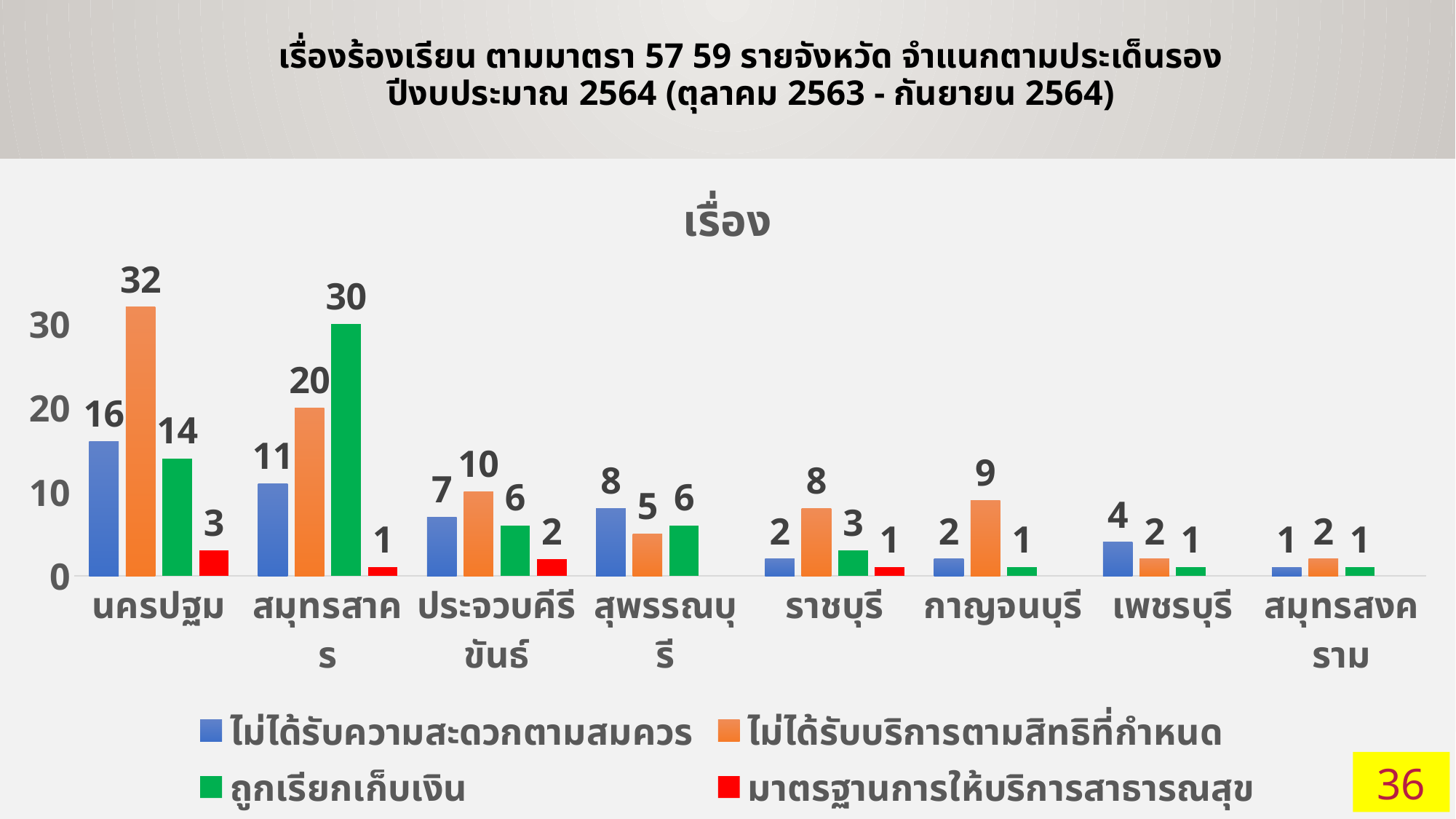
Which is larger for กาญจนบุรี: ไม่ได้รับบริการตามสิทธิที่กำหนด or ไม่ได้รับความสะดวกตามสมควร? ไม่ได้รับบริการตามสิทธิที่กำหนด How many series does the legend list? 4 What colour represents the series ถูกเรียกเก็บเงิน? green What is the value of ไม่ได้รับบริการตามสิทธิที่กำหนด for นครปฐม? 32 How many provinces (categories) are shown on the x axis? 8 Which province has the highest value for ไม่ได้รับความสะดวกตามสมควร? นครปฐม What is the difference between ไม่ได้รับบริการตามสิทธิที่กำหนด and ไม่ได้รับความสะดวกตามสมควร for นครปฐม? 16 What type of chart is shown on the slide? bar chart Which province has the lowest value for ไม่ได้รับบริการตามสิทธิที่กำหนด? เพชรบุรี and สมุทรสงคราม (both 2) What is the value of มาตรฐานการให้บริการสาธารณสุข for ประจวบคีรีขันธ์? 2 What is the value of ถูกเรียกเก็บเงิน for สมุทรสาคร? 30 What is the value of ไม่ได้รับความสะดวกตามสมควร for สุพรรณบุรี? 8